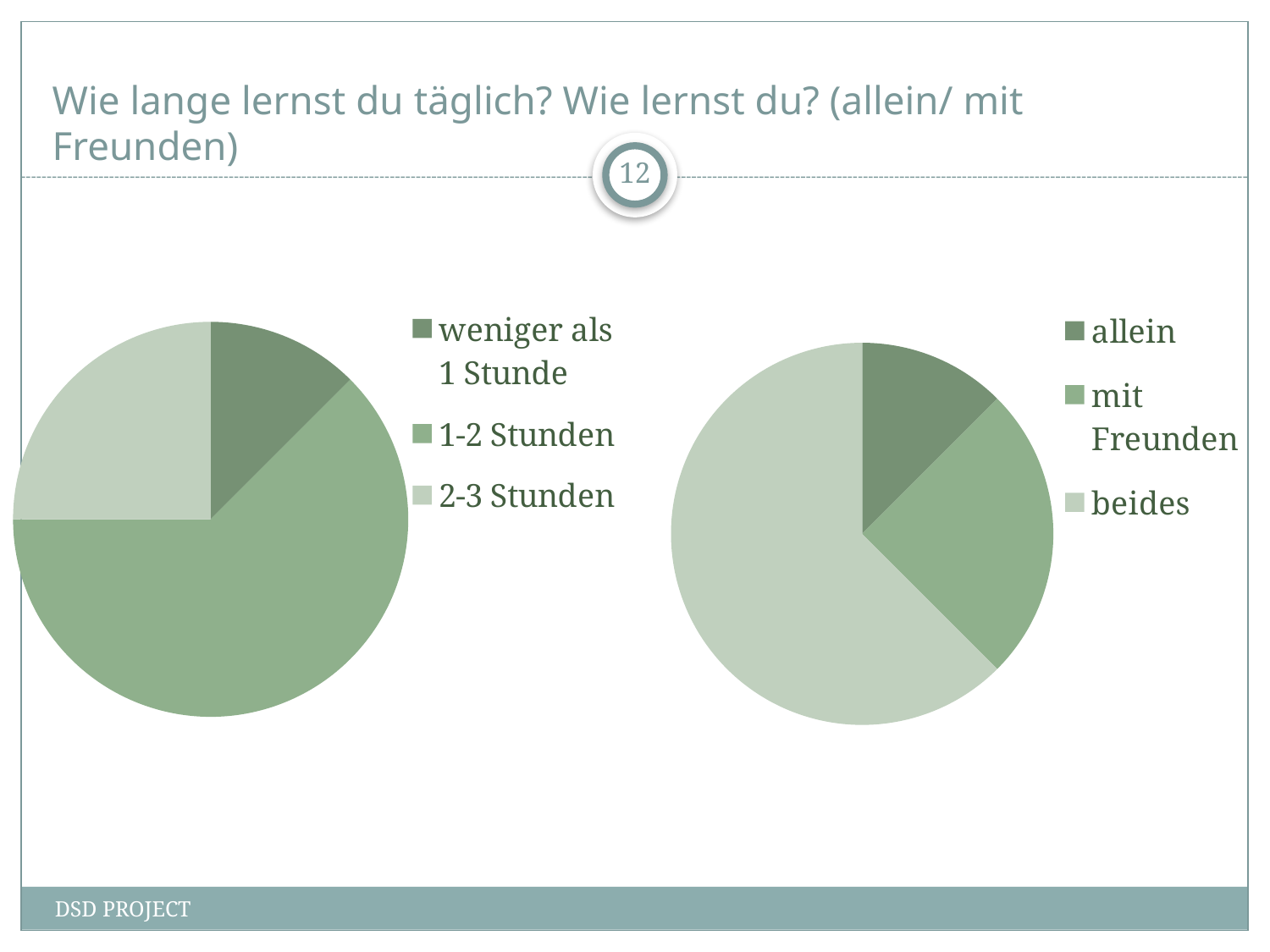
What are the legend entries of the left pie chart? weniger als 1 Stunde, 1-2 Stunden, 2-3 Stunden What kind of chart is the right chart on the slide? pie chart How many categories does the right pie chart show? 3 How many categories does the left pie chart show? 3 In the left pie chart, which category has the largest slice? 1-2 Stunden In the right pie chart, which category has the smallest slice? allein What kind of chart is the left chart on the slide? pie chart What are the legend entries of the right pie chart? allein, mit Freunden, beides In the left pie chart, which slice is larger: 2-3 Stunden or weniger als 1 Stunde? 2-3 Stunden In the right pie chart, which category has the largest slice? beides In the left pie chart, which category has the smallest slice? weniger als 1 Stunde In the right pie chart, which slice is larger: mit Freunden or allein? mit Freunden